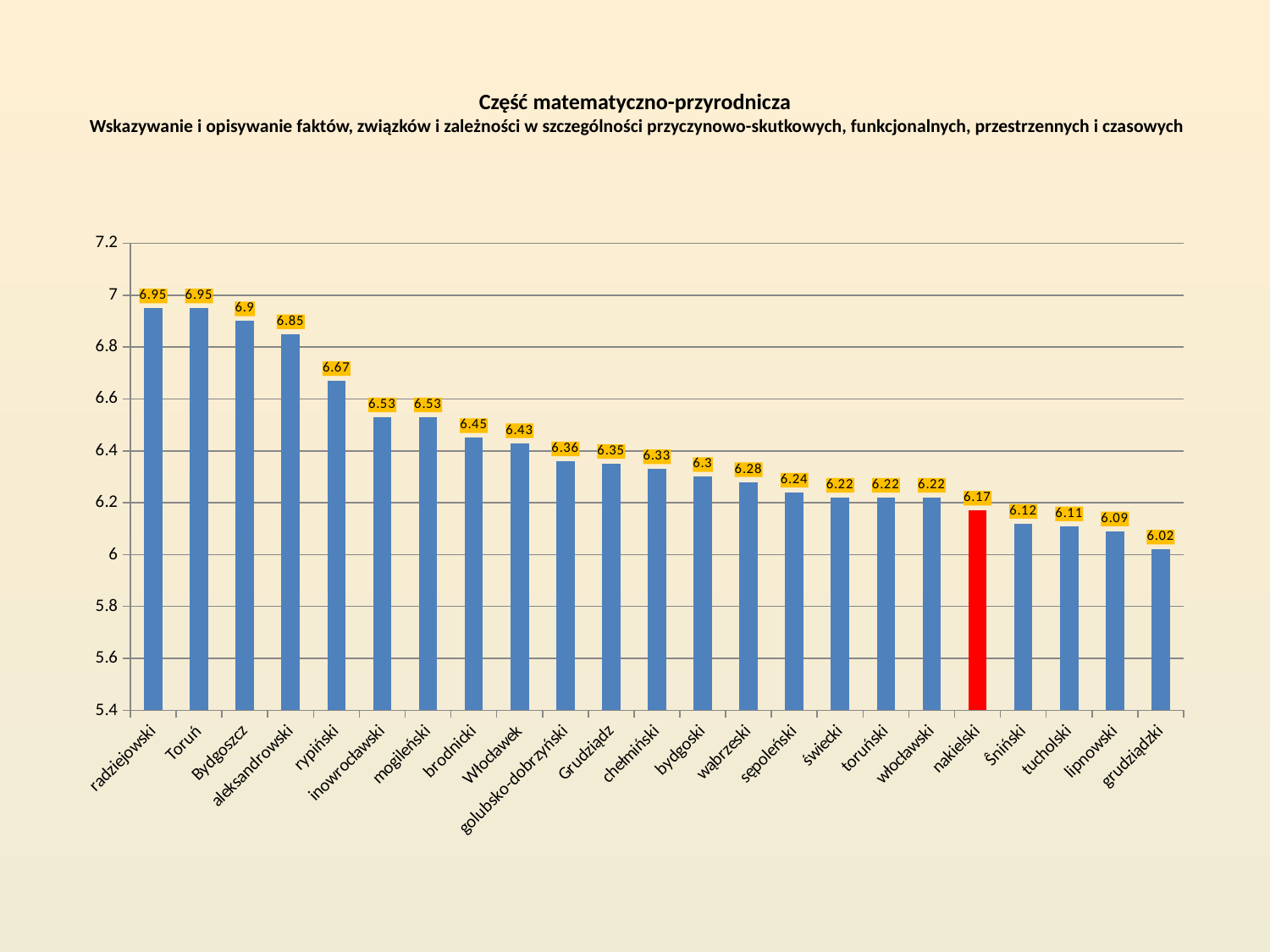
Which category has the lowest value? grudziądzki Is the value for wąbrzeski greater or less than 6.4? less Which is larger, the value for brodnicki or the value for Włocławek? brodnicki What is the difference between the values for nakielski and grudziądzki? 0.15 Which bar is coloured red instead of blue? nakielski What is the value for grudziądzki? 6.02 What is the value for Bydgoszcz? 6.9 What is the value for nakielski? 6.17 What kind of chart is shown on the slide? bar chart How many categories are shown on the x axis? 23 What is the value for rypiński? 6.67 What is the difference between the values for aleksandrowski and rypiński? 0.18